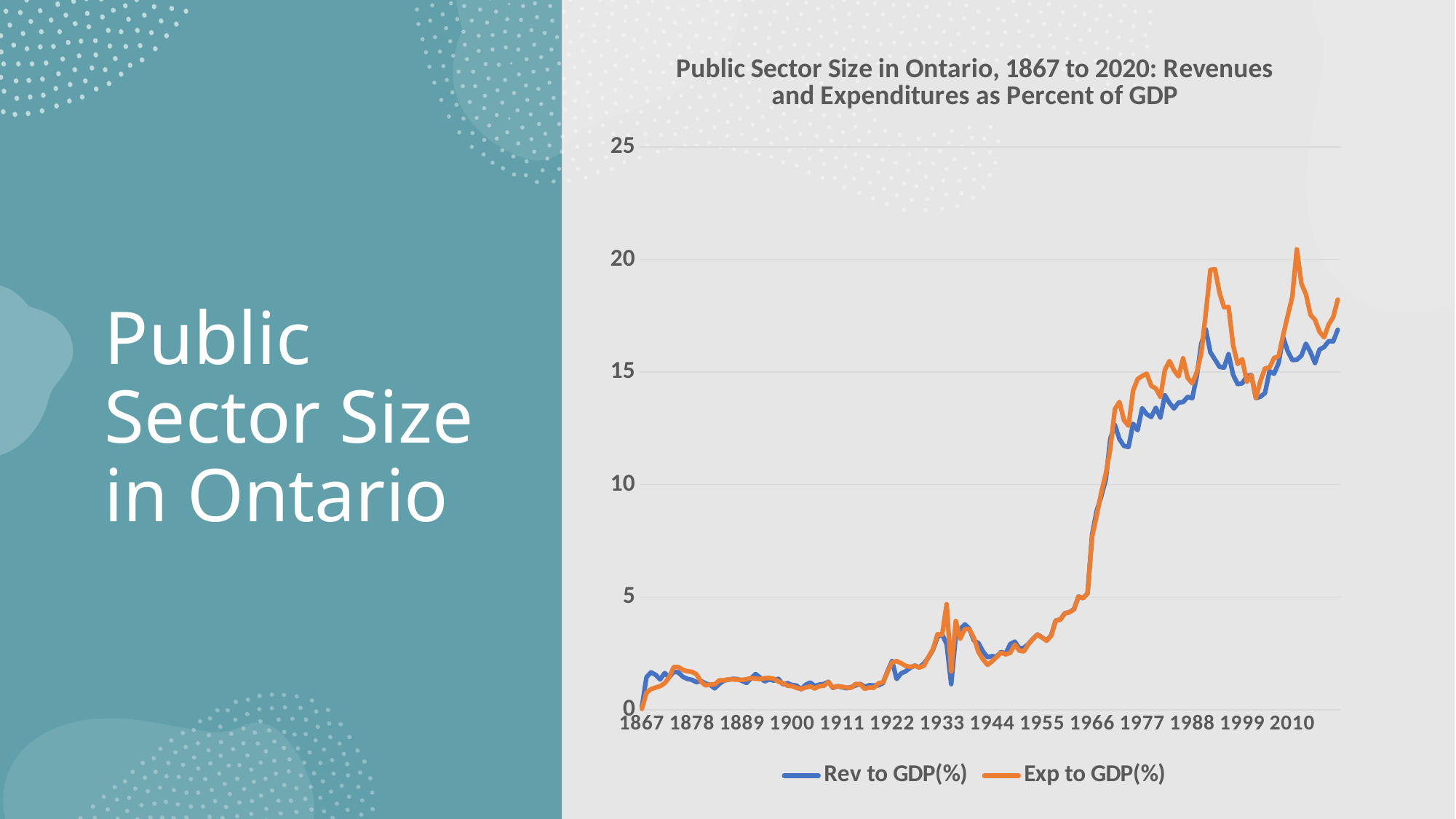
Is the value for Rev to GDP(%) in 1900 greater or less than 5? less Is the value for Rev to GDP(%) in 1977 greater or less than 10? greater How many year labels are shown along the x axis? 14 What are the two series named in the legend? Rev to GDP(%) and Exp to GDP(%) How many series does the legend list? 2 Overall, do the values rise or fall from 1867 to 2020? Rise What is the title of the chart? Public Sector Size in Ontario, 1867 to 2020: Revenues and Expenditures as Percent of GDP Is the value for Exp to GDP(%) in 1867 greater or less than 5? less What kind of chart is shown on the slide? Line chart Which series reaches the higher peak value on the chart, Rev to GDP(%) or Exp to GDP(%)? Exp to GDP(%)